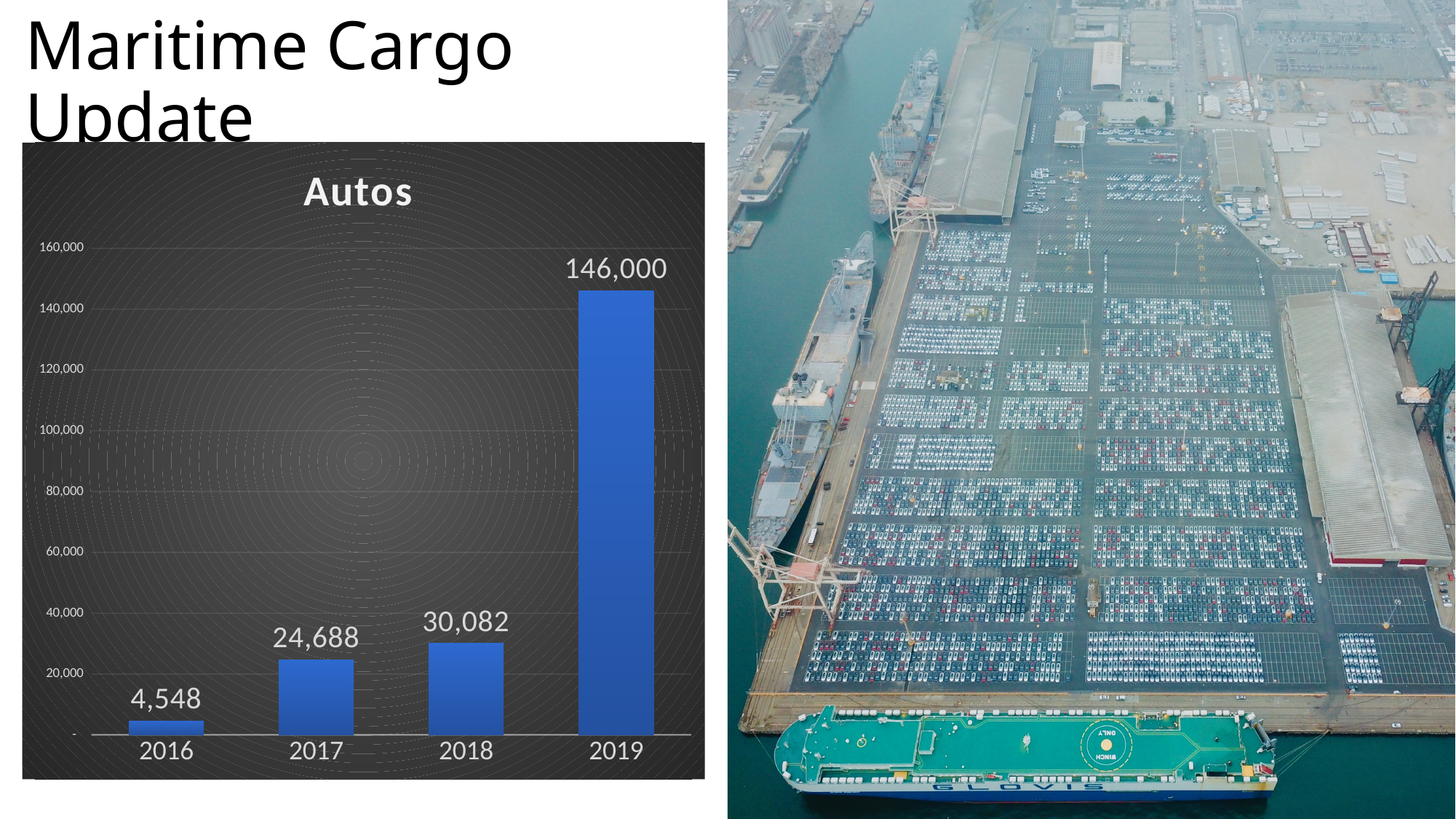
Which year has the highest value in the Autos chart? 2019 What is the value for 2018 in the Autos chart? 30,082 What is the value for 2019 in the Autos chart? 146,000 What kind of chart is the Autos chart? bar chart Is the value for 2019 in the Autos chart greater or less than 140,000? greater Do the values in the Autos chart rise or fall from 2016 to 2019? rise What is the value for 2016 in the Autos chart? 4,548 Which is larger in the Autos chart, the value for 2017 or the value for 2018? 2018 How many years are shown in the Autos chart? 4 What is the difference between the 2018 and 2017 values in the Autos chart? 5,394 What is the value for 2017 in the Autos chart? 24,688 Which year has the lowest value in the Autos chart? 2016